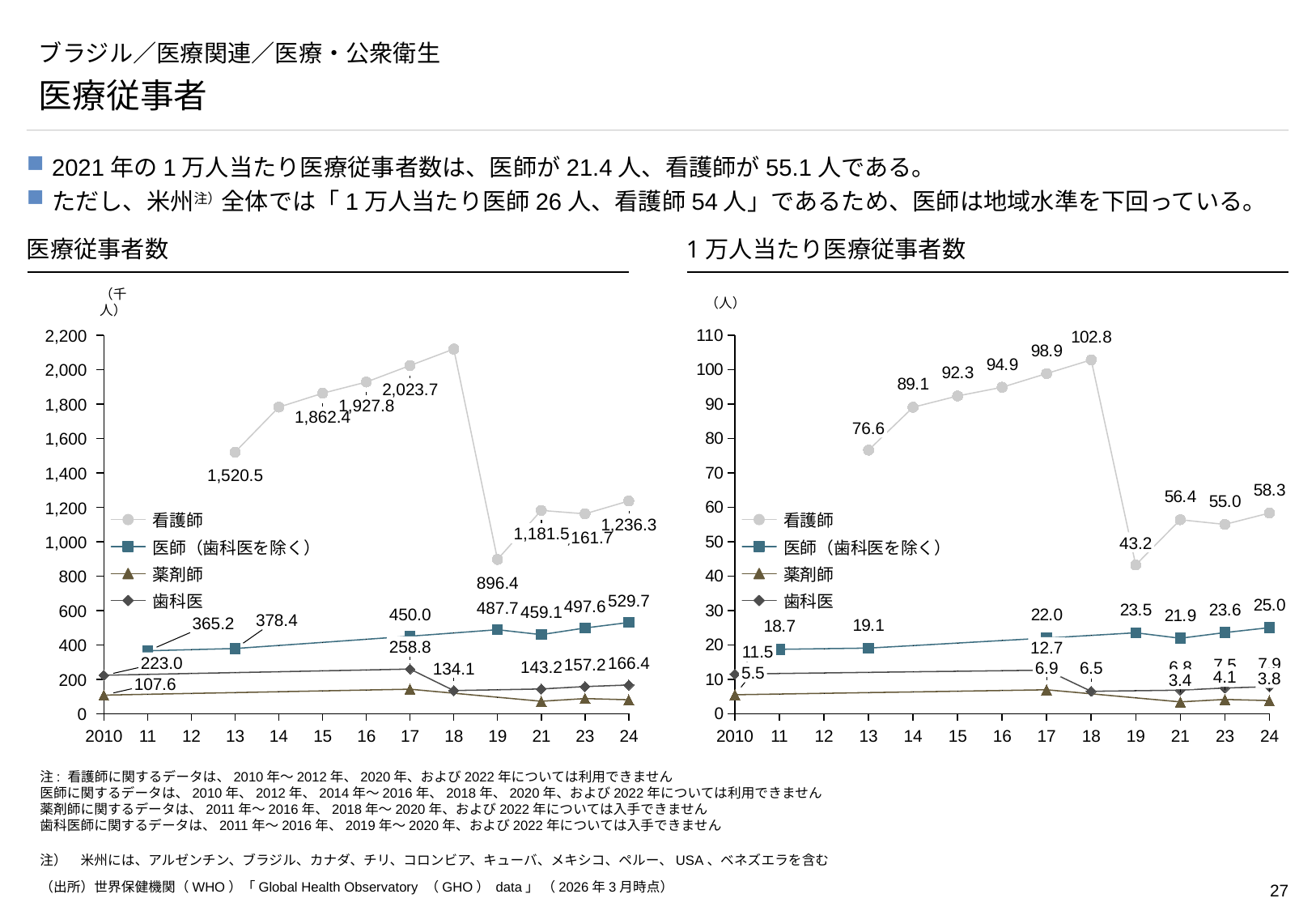
In the right chart (1万人当たり医療従事者数), in which year does 看護師 reach its highest value? 2018 How many series does the legend of the right chart (1万人当たり医療従事者数) list? 4 In the left chart (医療従事者数), which is larger: the 看護師 value in 2017 or in 2019? 2017 In the right chart (1万人当たり医療従事者数), what is the difference between the 医師（歯科医を除く） values for 2024 and 2023? 1.4 In the right chart (1万人当たり医療従事者数), does the 看護師 value rise or fall from 2013 to 2018? Rise In the left chart (医療従事者数), what is the value for 看護師 in 2013? 1,520.5 In the left chart (医療従事者数), what is the value for 医師（歯科医を除く） in 2024? 529.7 In the right chart (1万人当たり医療従事者数), what is the value for 看護師 in 2018? 102.8 In the right chart (1万人当たり医療従事者数), what is the value for 薬剤師 in 2024? 3.8 In the left chart (医療従事者数), is the 看護師 value for 2018 greater or less than 2,000? greater In the right chart (1万人当たり医療従事者数), in which year is the 看護師 value lowest? 2019 What kind of chart is the left chart (医療従事者数)? Line chart